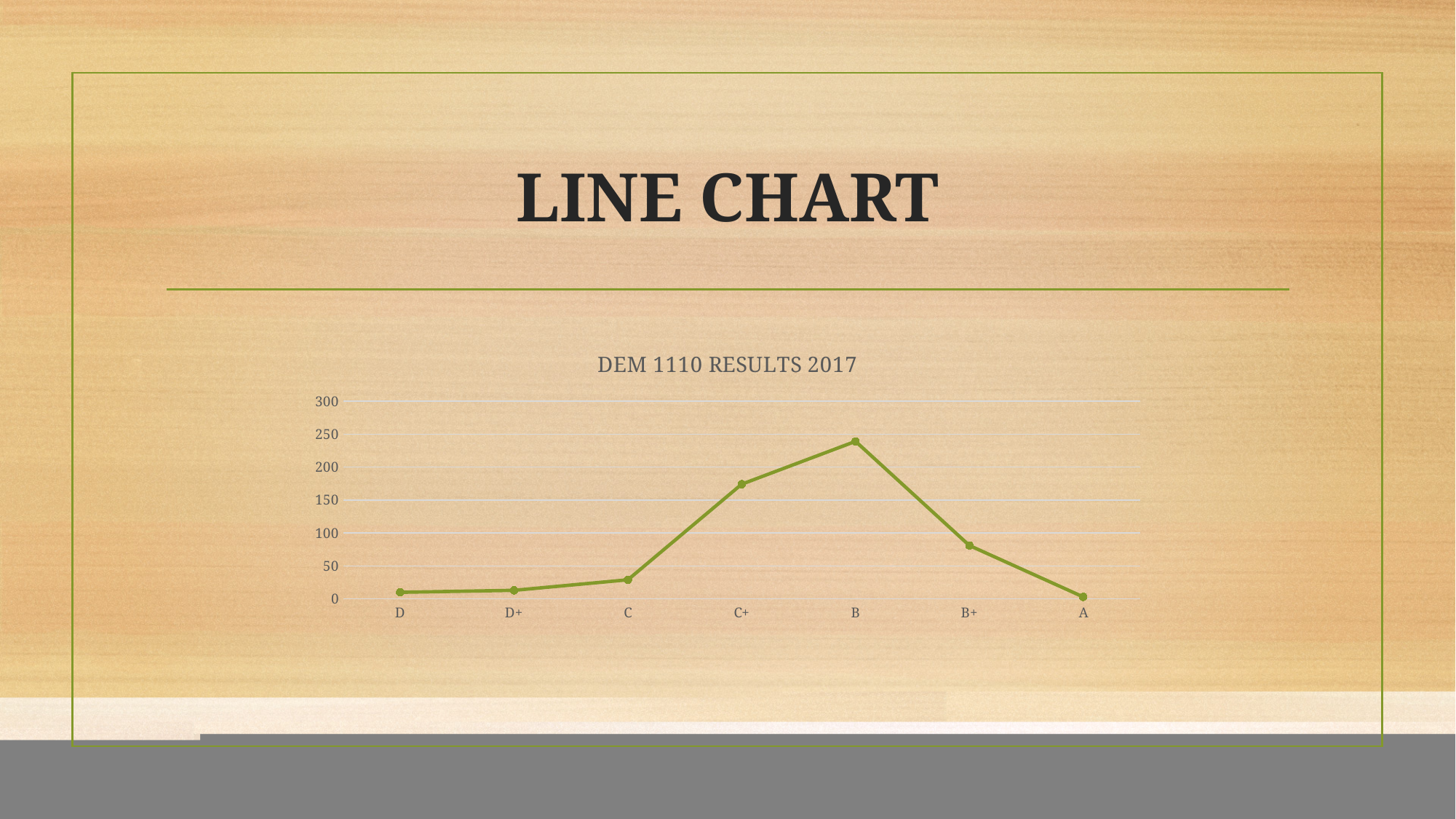
Is the value for C greater or less than 50? less Which has a larger value, C+ or B+? C+ How many grade categories are plotted along the x axis? 7 Which grade category has the highest value? B Do the values rise or fall from B to A along the x axis? fall Is the value for C+ greater or less than 150? greater What is the title of the chart? DEM 1110 RESULTS 2017 Is the value for B greater or less than 200? greater What kind of chart is shown on the slide? line chart Do the values rise or fall from D to B along the x axis? rise Which has a larger value, C or B? B